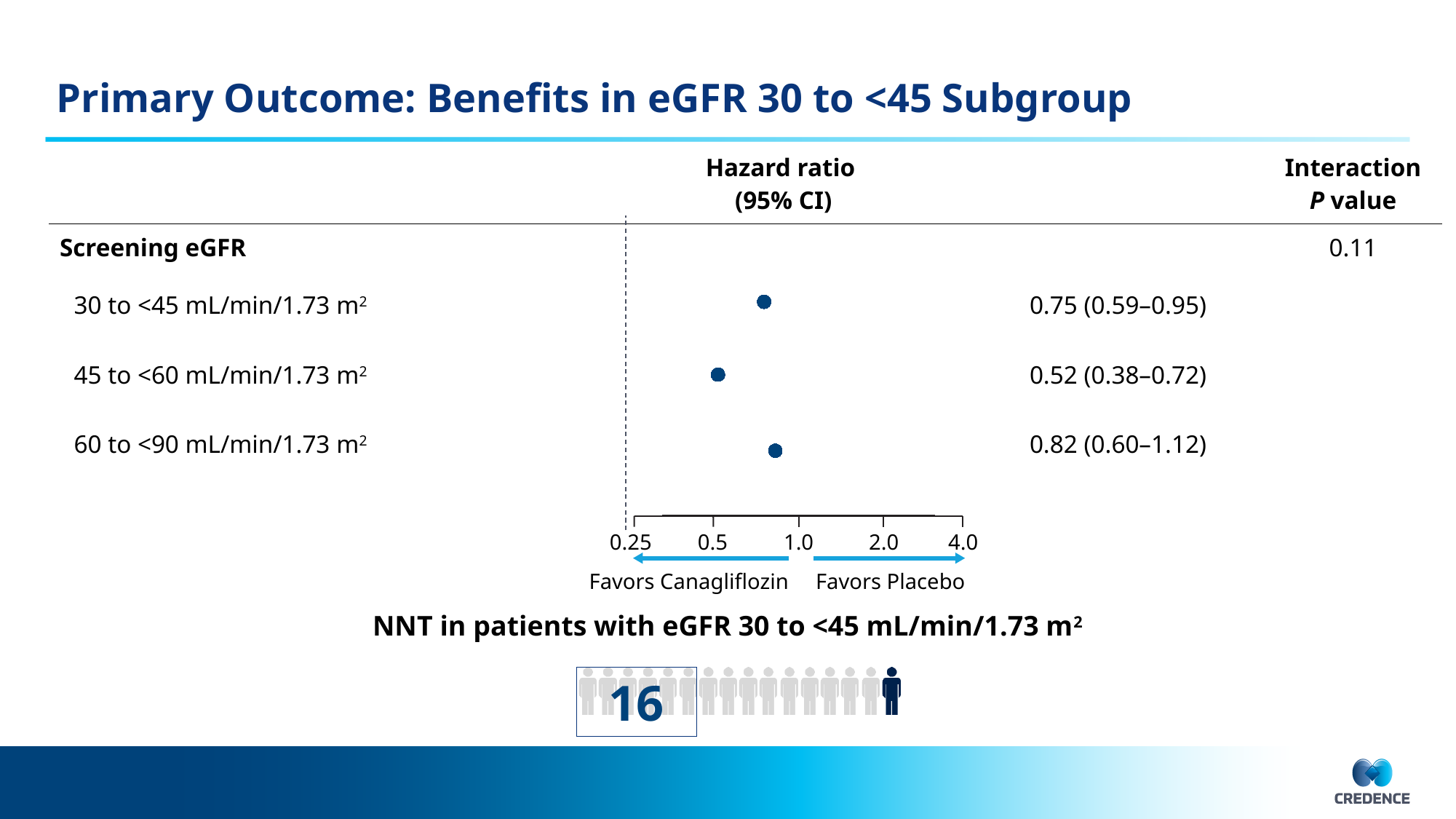
Is the hazard ratio for the 30 to <45 mL/min/1.73 m² subgroup larger or smaller than that for the 45 to <60 mL/min/1.73 m² subgroup? larger What is the hazard ratio (95% CI) for the 45 to <60 mL/min/1.73 m² subgroup? 0.52 (0.38–0.72) What is the hazard ratio (95% CI) for the 30 to <45 mL/min/1.73 m² screening eGFR subgroup? 0.75 (0.59–0.95) What is the hazard ratio (95% CI) for the 60 to <90 mL/min/1.73 m² subgroup? 0.82 (0.60–1.12) What does the left-pointing arrow below the hazard ratio axis indicate? Favors Canagliflozin What is the interaction P value shown for screening eGFR? 0.11 What is the difference between the hazard ratios for the 60 to <90 and 30 to <45 mL/min/1.73 m² subgroups? 0.07 How many screening eGFR subgroups are plotted in the forest plot? 3 What kind of chart is used to display the hazard ratios? Forest plot (dot plot) Is the hazard ratio point estimate for the 60 to <90 mL/min/1.73 m² subgroup greater or less than 1.0? less Which screening eGFR subgroup has the lowest hazard ratio? 45 to <60 mL/min/1.73 m² Which screening eGFR subgroup has the highest hazard ratio? 60 to <90 mL/min/1.73 m²